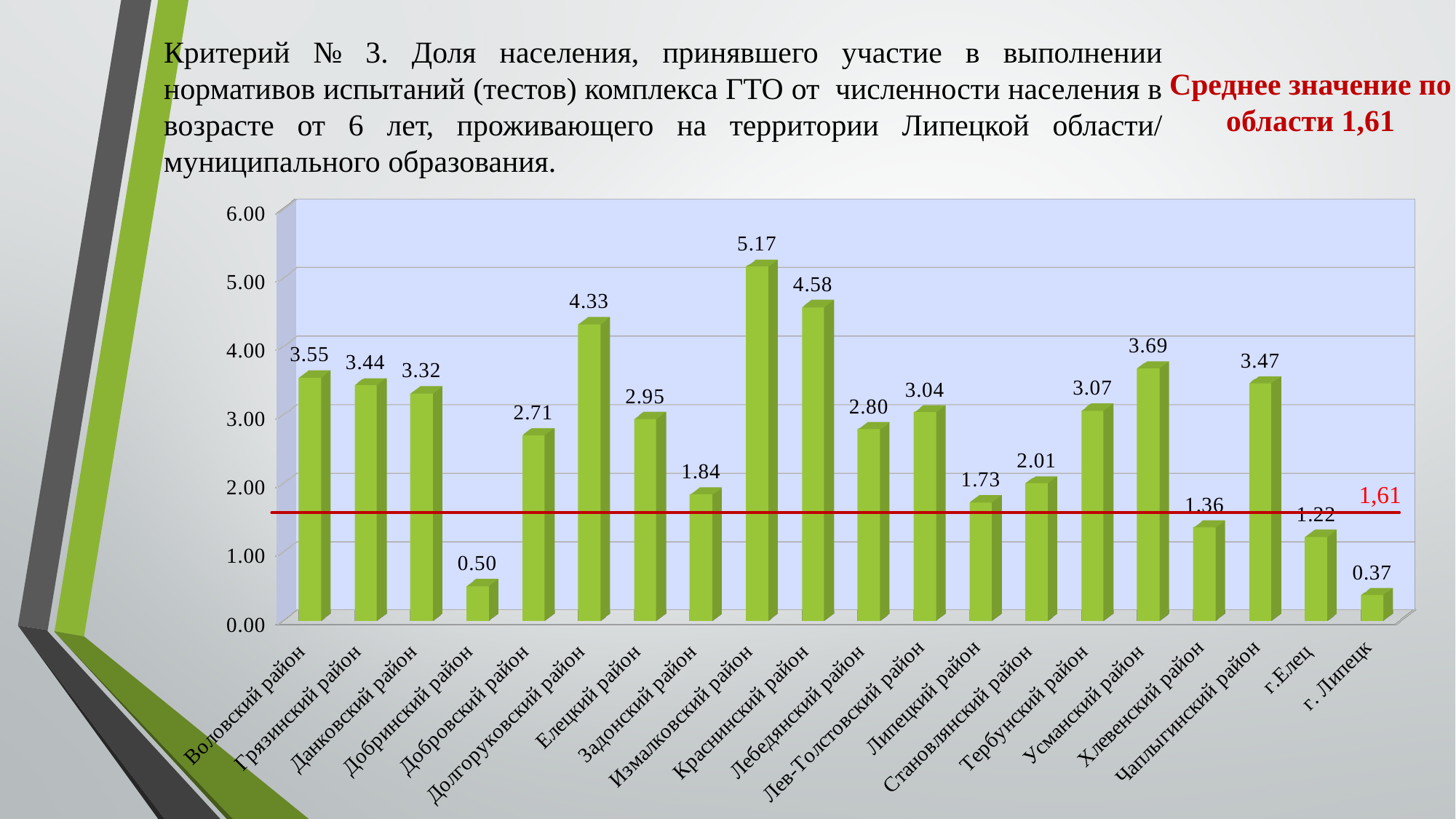
Which is larger, the value for Усманский район or the value for Чаплыгинский район? Усманский район Which category has the lowest value? г. Липецк What is the value for Измалковский район? 5.17 What value does the red horizontal line on the chart mark? 1,61 Which category has the highest value? Измалковский район What is the difference between the values for Долгоруковский район and Краснинский район? 0.25 Is the value for Хлевенский район greater or less than 2.00? less What is the value for г.Елец? 1.22 What is the difference between the values for Измалковский район and г. Липецк? 4.80 What is the value for Добринский район? 0.50 How many categories are shown on the x axis? 20 What kind of chart is shown on the slide? bar chart